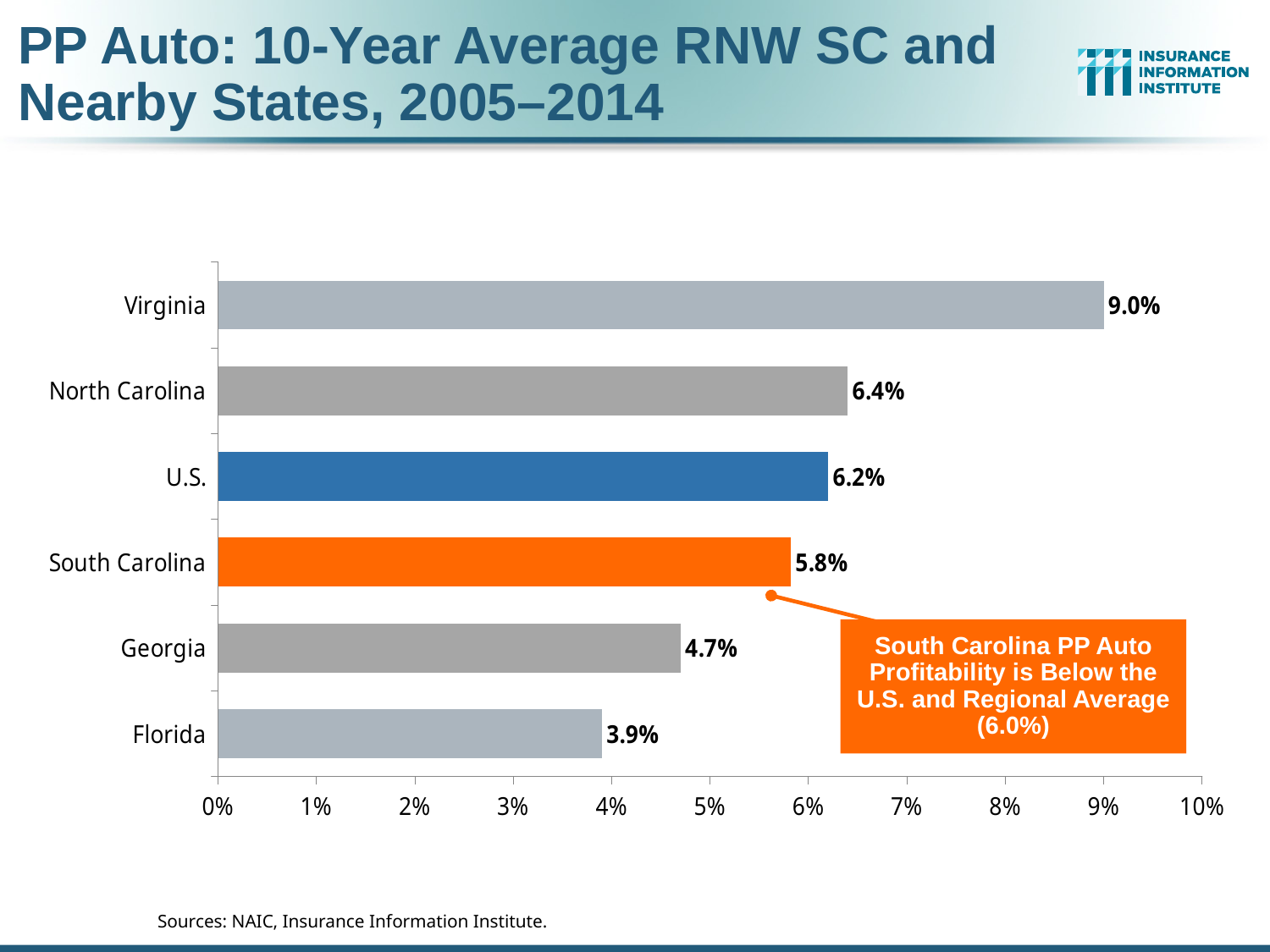
What is the difference between Virginia's value and South Carolina's value? 3.2% What is the value shown for the U.S.? 6.2% Which state has the lowest 10-year average RNW? Florida What is the 10-year average RNW for South Carolina? 5.8% How many categories are shown on the chart? 6 What regional average value is stated in the callout box? 6.0% What kind of chart is shown on the slide? Bar chart Which is larger, the value for North Carolina or the value for Georgia? North Carolina What is the value shown for Virginia? 9.0% What is the difference between the U.S. value and Georgia's value? 1.5% Which state has the highest 10-year average RNW? Virginia Is the value for Florida greater or less than 4%? less